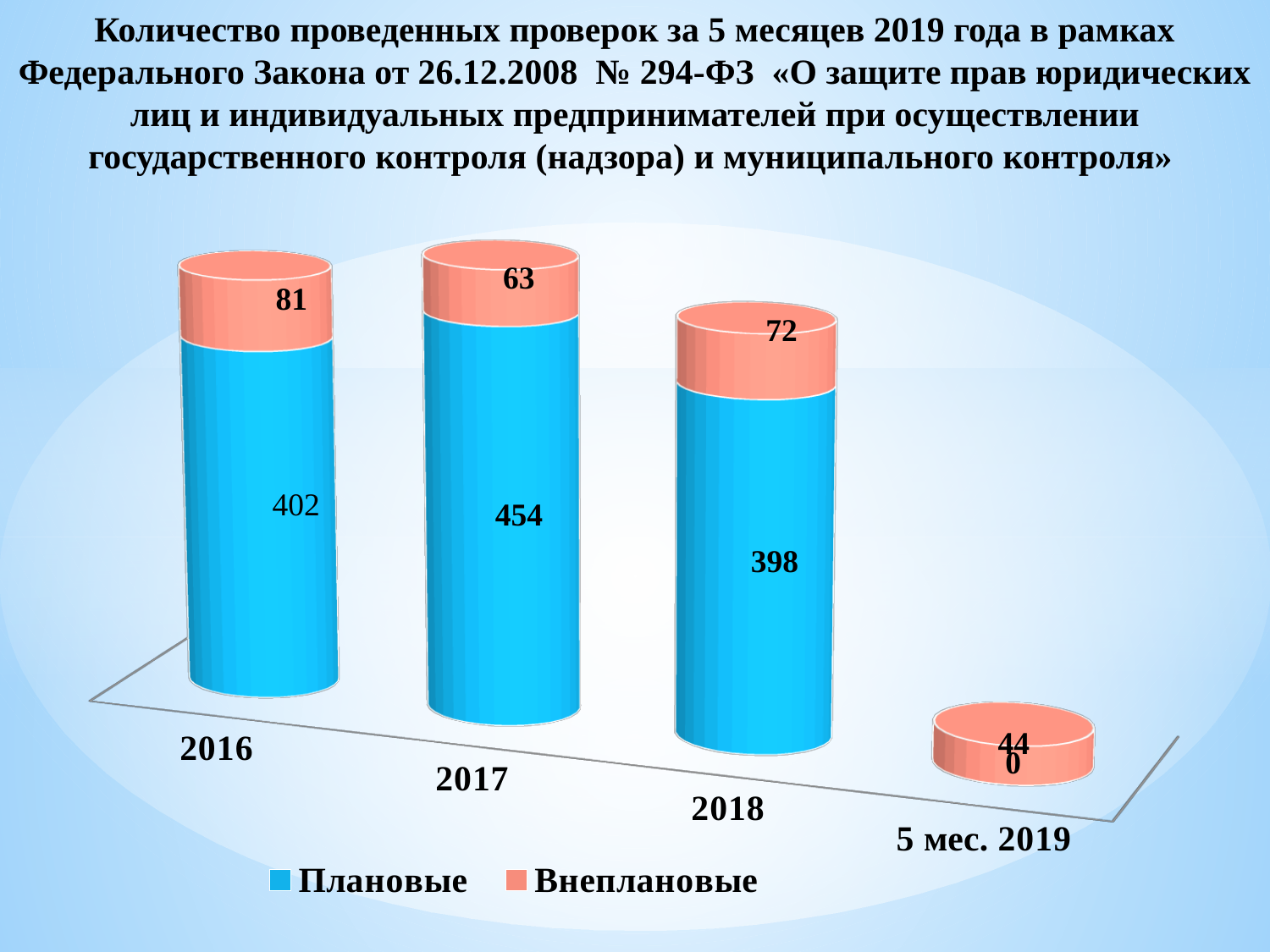
What is the total of the stacked bar for 2016? 483 Which category has the lowest value for Внеплановые? 5 мес. 2019 What kind of chart is shown on the slide? Stacked bar chart How many series does the legend list? 2 What is the value of Плановые for 2017? 454 What is the difference between Плановые in 2017 and Плановые in 2018? 56 What is the total of the stacked bar for 2018? 470 Which category has the highest value for Плановые? 2017 What is the value of Плановые for 5 мес. 2019? 0 What is the value of Внеплановые for 2016? 81 Which is larger: Внеплановые in 2016 or Внеплановые in 2018? 2016 How many categories are shown on the x axis? 4